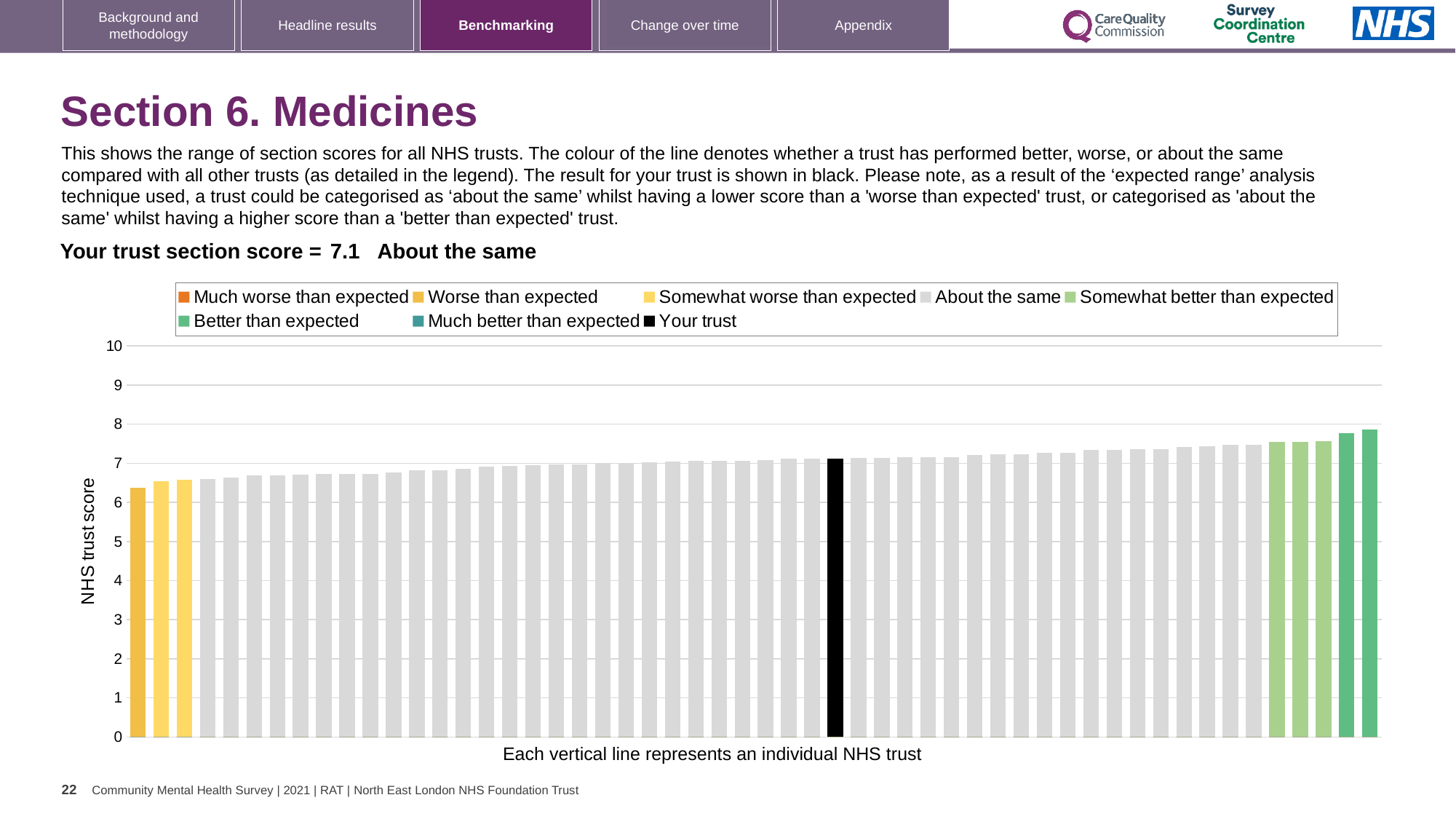
What kind of chart is shown on the slide? bar chart What is the label on the vertical axis of the chart? NHS trust score Is the black bar for your trust higher or lower than the rightmost bar? lower How many entries does the chart legend list? 8 What colour is the bar representing your trust? black What is the section score for your trust shown on the slide? 7.1 Is the black bar for your trust higher or lower than the leftmost bar? higher Is the value of the rightmost bar greater or less than 7? greater Do the bar values rise or fall from left to right along the x axis? rise Which category is your trust placed in for this section? About the same Is the value of the leftmost bar greater or less than 6? greater Is the value of the black bar (your trust) greater or less than 5? greater